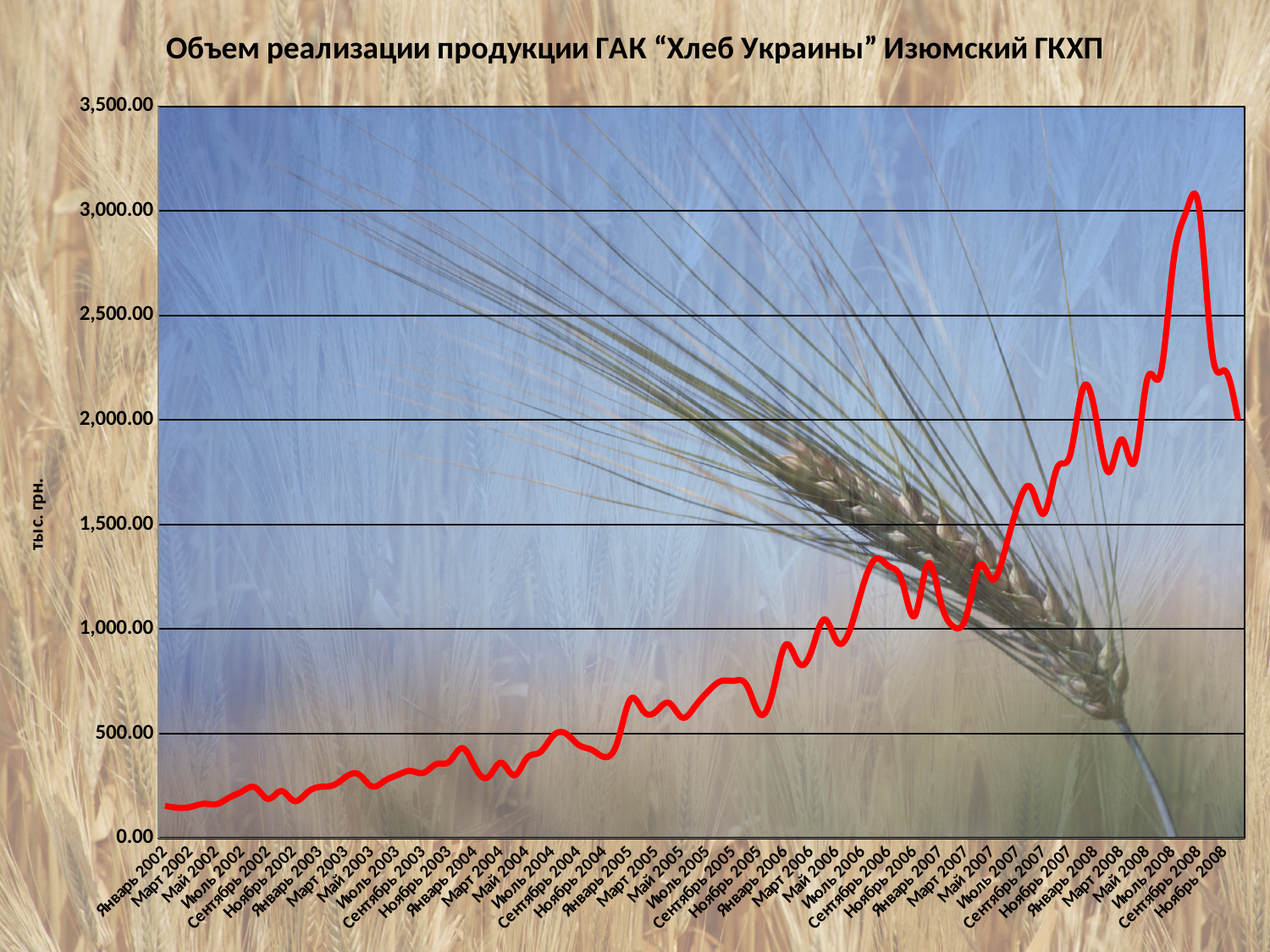
Which is larger, the value for Январь 2006 or the value for Январь 2008? Январь 2008 Is the value for Сентябрь 2006 greater or less than 1,000.00? greater In which year does the line reach its highest value? 2008 Is the value for Январь 2002 greater or less than 500.00? less Is the value for Ноябрь 2007 greater or less than 1,500.00? greater Overall, do the values rise or fall from Январь 2002 to Ноябрь 2008? rise In which year does the line have its lowest values? 2002 What kind of chart is shown on the slide? line chart What is the label of the vertical axis? тыс. грн. What is the title of the chart? Объем реализации продукции ГАК "Хлеб Украины" Изюмский ГКХП What is the highest tick value shown on the vertical axis? 3,500.00